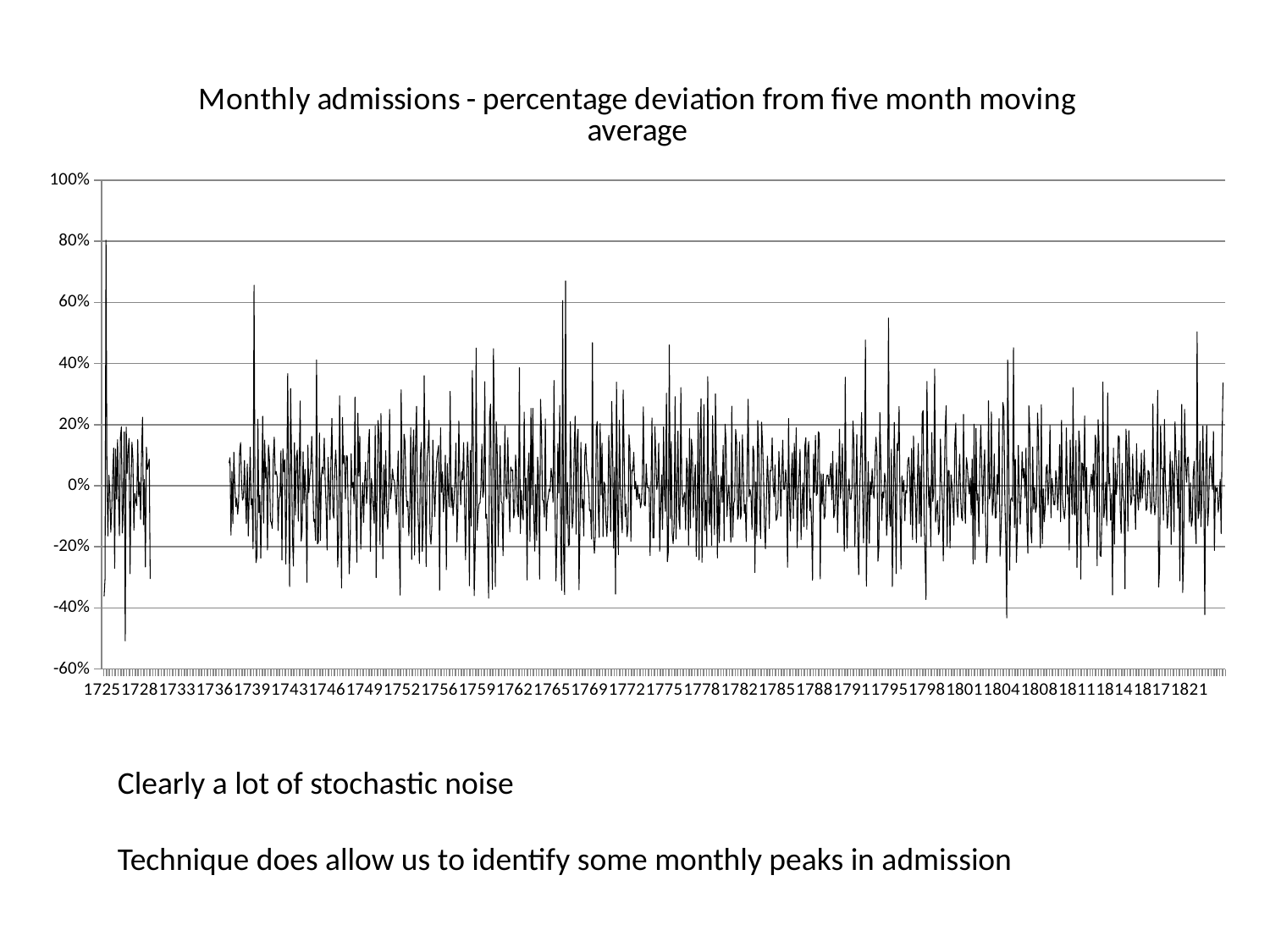
Near which x-axis label does the highest peak of the line occur? 1725 What is the last label shown on the x axis? 1821 What is the highest tick value shown on the y axis? 100% What is the lowest tick value shown on the y axis? -60% Is there a gap with no plotted data between the x-axis labels 1728 and 1736? yes Is the highest peak of the plotted line greater or less than 100%? less What is the first label shown on the x axis? 1725 Is the lowest trough of the plotted line greater or less than -60%? greater What kind of chart is shown on the slide? line chart Is the highest peak of the plotted line greater or less than 60%? greater What is the title of the chart? Monthly admissions - percentage deviation from five month moving average